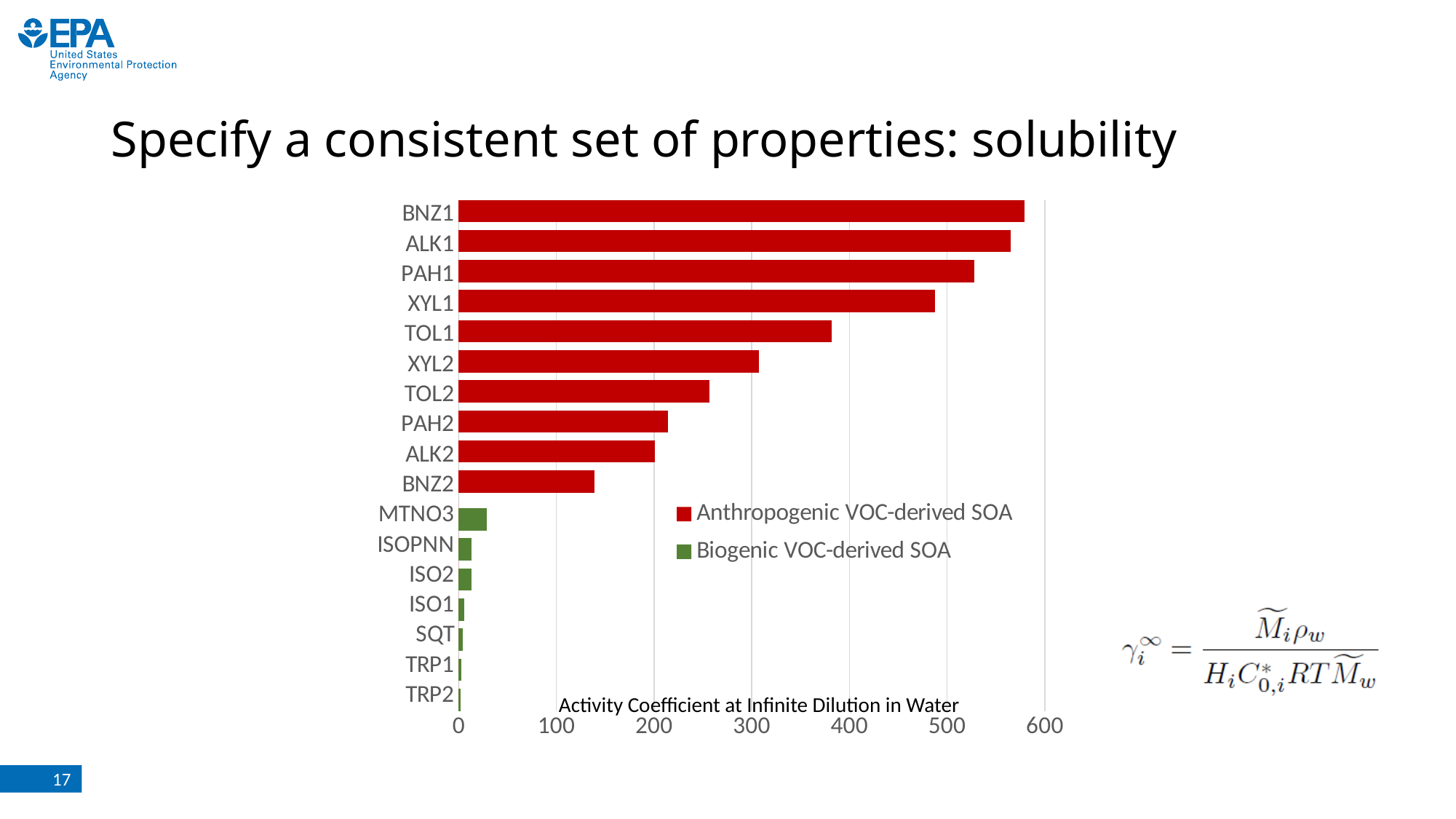
What kind of chart is shown on the slide? bar chart What is the title of the horizontal axis of the chart? Activity Coefficient at Infinite Dilution in Water Is the value for PAH1 greater or less than 500? greater Which is larger, the value for BNZ2 or the value for MTNO3? BNZ2 Which is larger, the value for TOL1 or the value for XYL2? TOL1 Which legend entry is shown in green? Biogenic VOC-derived SOA Is the value for MTNO3 greater or less than 100? less Is the value for TOL1 greater or less than 400? less How many series does the legend list? 2 How many categories are plotted on the chart? 17